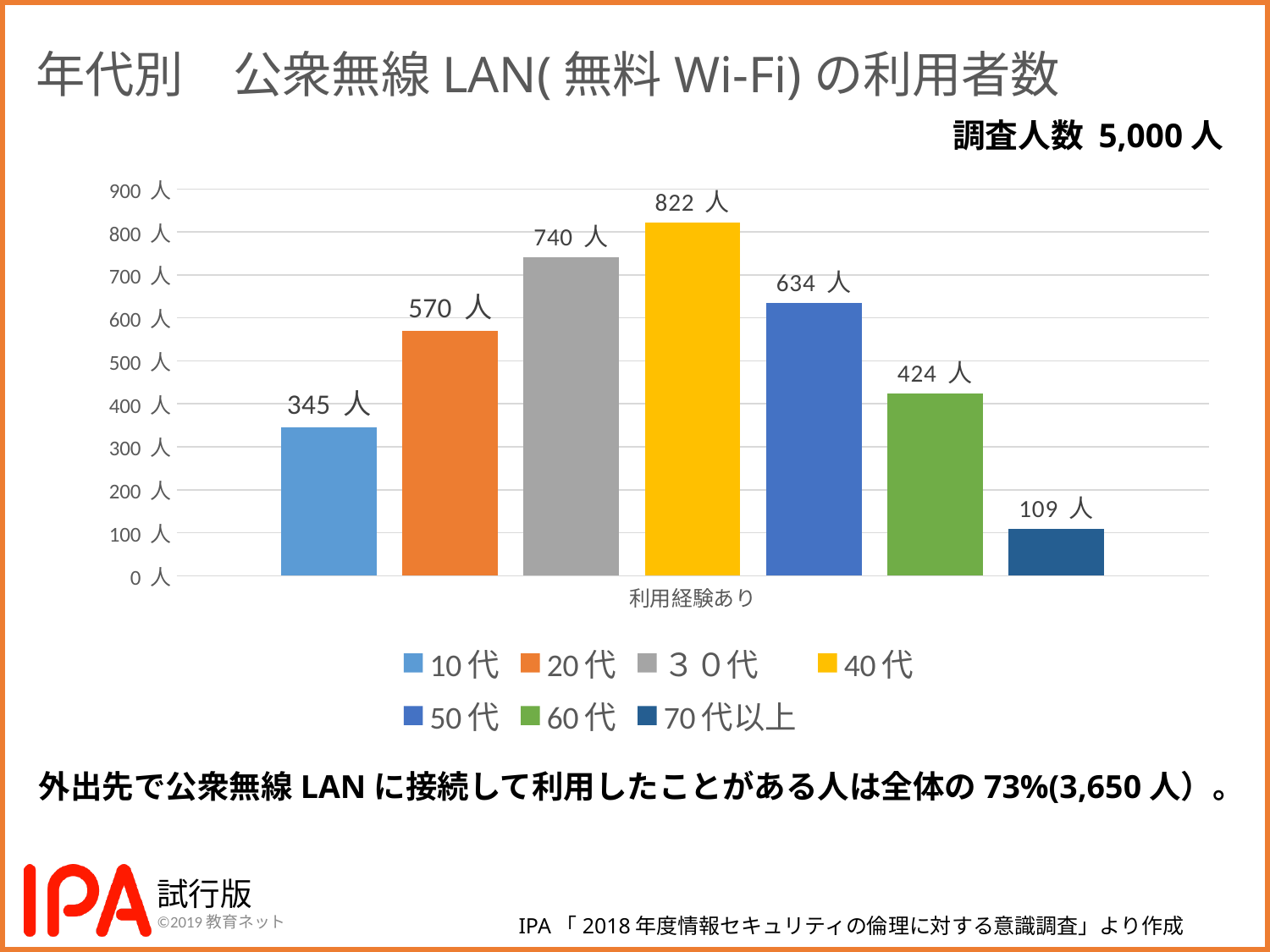
What is the category label shown on the x axis? 利用経験あり Which is larger, the value for 50代 or the value for 60代? 50代 How many age groups (series) does the legend list? 7 What is the value for 40代 (people in their 40s)? 822 人 Which age group has the lowest number of users? 70代以上 What kind of chart is shown on the slide? bar chart What is the value for 70代以上 (70s and over)? 109 人 What colour is the bar for 40代? yellow Which age group has the highest number of users? 40代 What is the value for 10代 (people in their 10s)? 345 人 What is the difference between the values for 30代 and 20代? 170 人 Is the value for 60代 greater or less than 400 人? greater